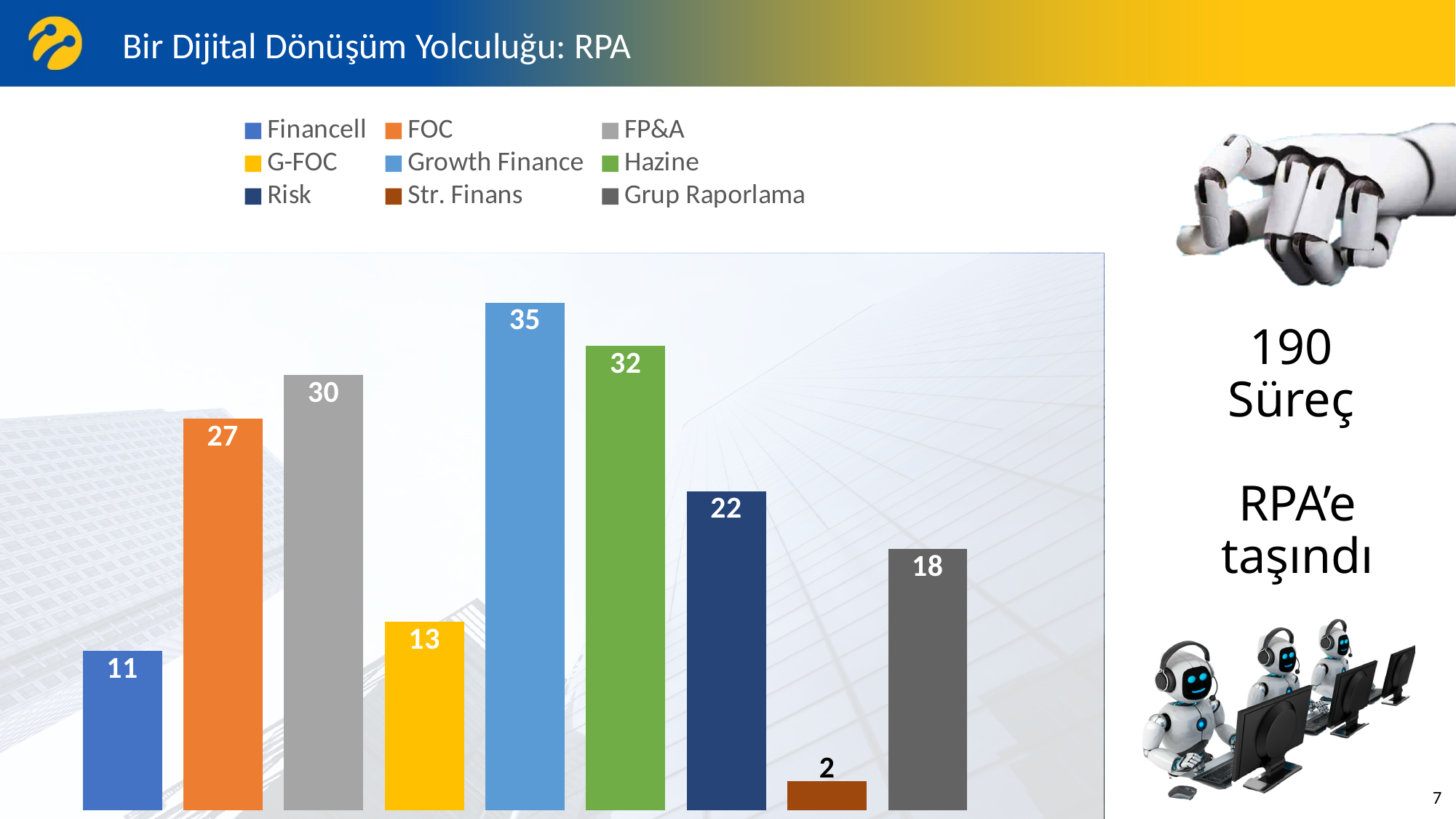
Which category has the lowest value? Str. Finans What is the value for Str. Finans? 2 What is the difference between the values for Risk and Financell? 11 What kind of chart is shown on the slide? Bar chart How many bars are plotted in the chart? 9 What is the value for Growth Finance? 35 What is the difference between the values for FP&A and FOC? 3 How many entries does the legend list? 9 What is the value for Hazine? 32 Which category has the highest value? Growth Finance What is the value for Grup Raporlama? 18 Which is larger, the value for G-FOC or the value for Grup Raporlama? Grup Raporlama